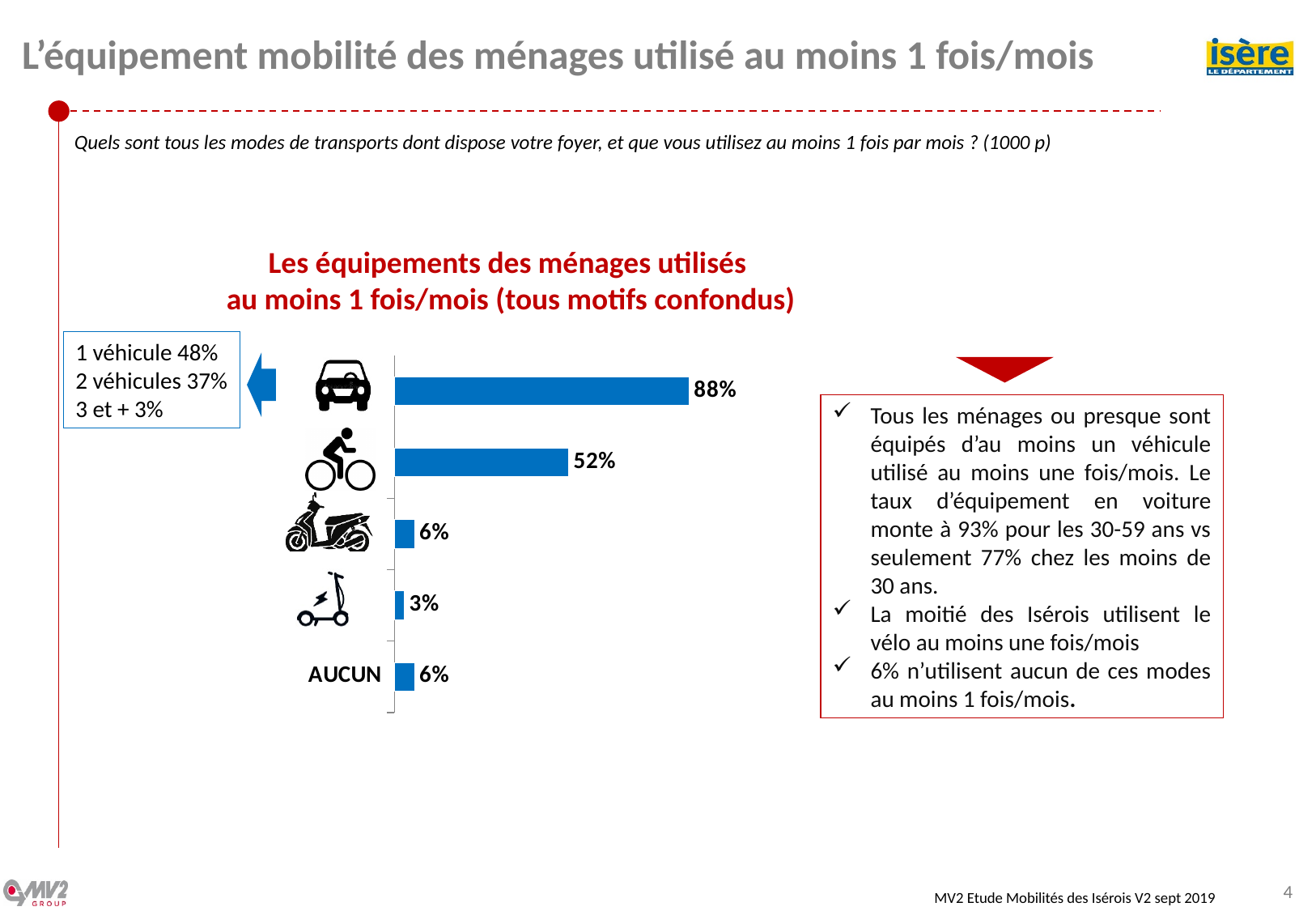
What is the difference between the car value and the bicycle value? 36% Which category has the highest value in the chart? The car (top bar), 88% What is the difference between the AUCUN value and the electric scooter value? 3% What value is shown for the AUCUN category? 6% How many categories (bars) are shown in the chart? 5 What is the title of the chart? Les équipements des ménages utilisés au moins 1 fois/mois (tous motifs confondus) Which category has the lowest value in the chart? The electric scooter (trottinette), 3% What type of chart is shown on the slide? Bar chart Which is larger, the value for the bicycle or the value for AUCUN? The bicycle What value is shown for the bar with the bicycle icon? 52% What value is shown for the bar with the electric scooter (trottinette) icon? 3% What value is shown for the top bar (car icon) in the chart? 88%